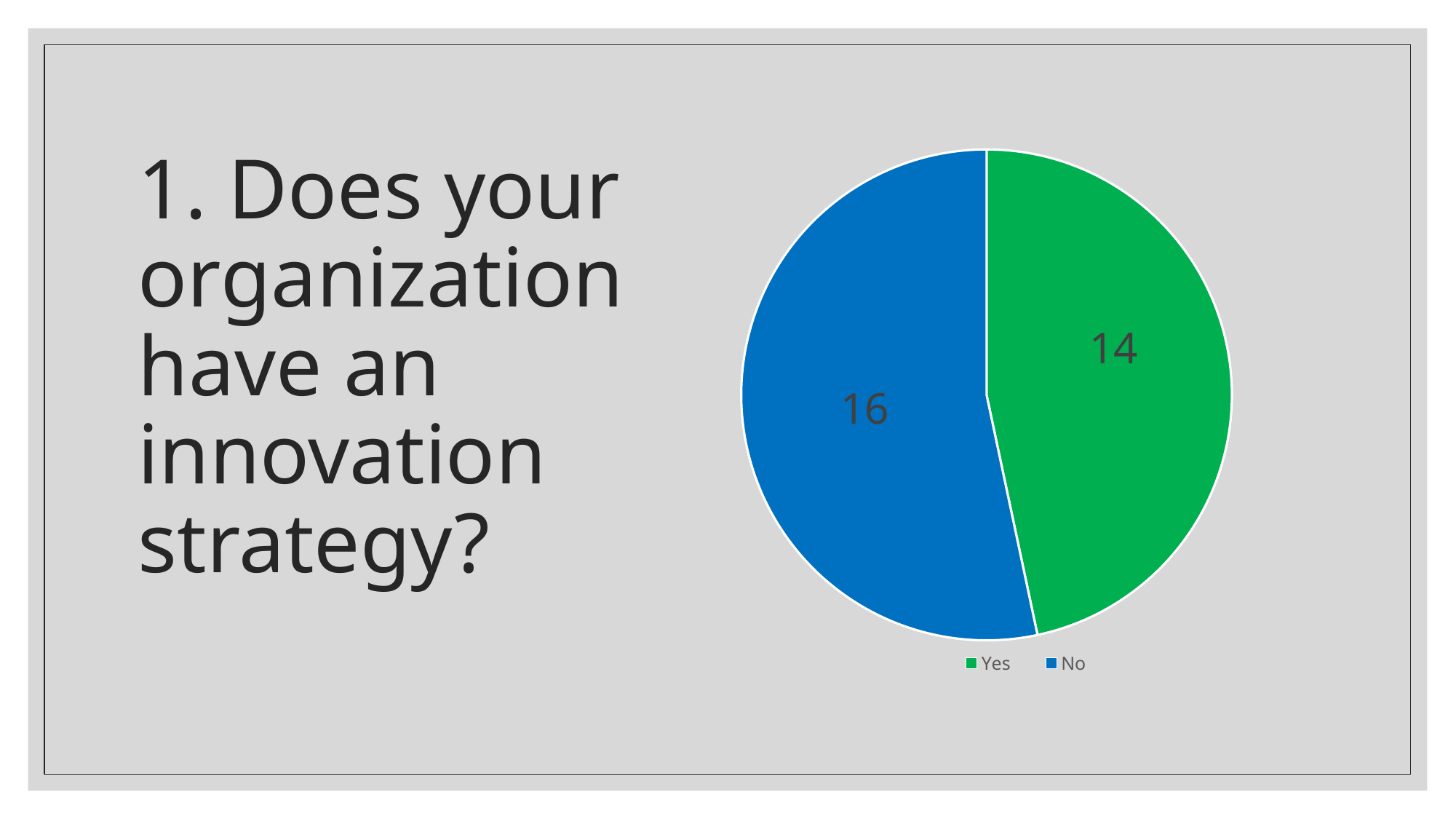
What colour is the Yes slice in the pie chart? Green How many entries does the legend of the pie chart list? 2 What is the value for Yes in the pie chart? 14 What is the difference between the No and Yes values in the pie chart? 2 Which is larger in the pie chart, Yes or No? No What colour is the No slice in the pie chart? Blue What kind of chart is shown on the slide? Pie chart Which category has the smallest slice in the pie chart? Yes Which category has the largest slice in the pie chart? No What is the total of all slices in the pie chart? 30 What is the value for No in the pie chart? 16 How many slices does the pie chart have? 2